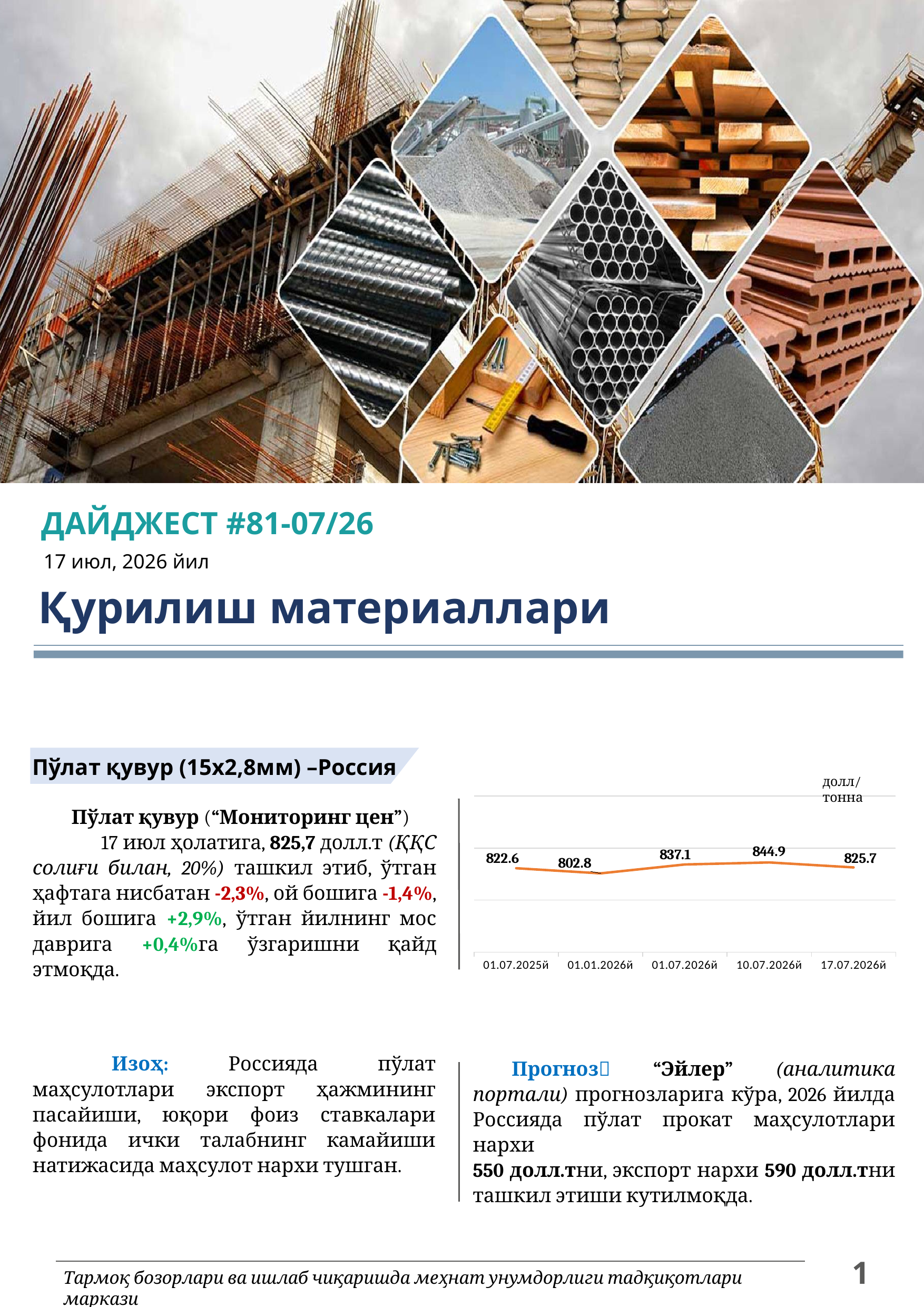
What is the value plotted for 17.07.2026й? 825.7 What unit is shown in the top-right corner of the chart? долл/тонна What is the value plotted for 01.01.2026й? 802.8 Which is larger, the value for 01.07.2025й or the value for 01.01.2026й? 01.07.2025й What is the value plotted for 01.07.2025й? 822.6 Which date has the highest value on the chart? 10.07.2026й What kind of chart is shown on the slide? line chart What is the difference between the values for 10.07.2026й and 17.07.2026й? 19.2 Which date has the lowest value on the chart? 01.01.2026й What is the difference between the values for 01.07.2026й and 01.01.2026й? 34.3 How many data points are plotted on the chart? 5 What is the value plotted for 10.07.2026й? 844.9